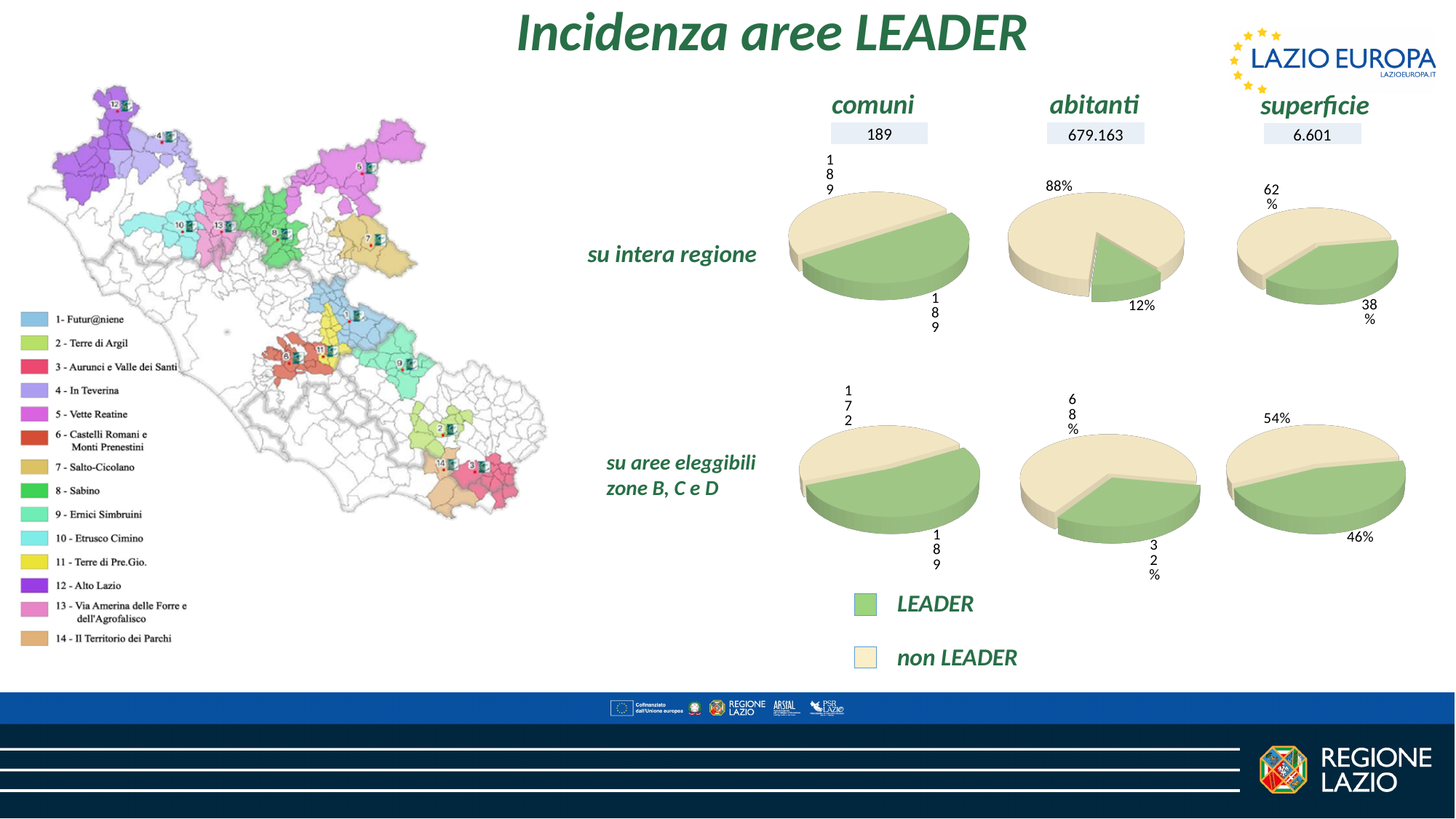
In the 'abitanti' pie chart for 'su intera regione', what percentage is labelled for the LEADER slice? 12% What kind of charts are used on the slide to show the incidence of LEADER areas? Pie charts In the 'abitanti' pie chart for 'su aree eleggibili zone B, C e D', what is the difference in percentage points between the non LEADER and LEADER slices? 36 In the 'abitanti' pie chart for 'su aree eleggibili zone B, C e D', what percentage is labelled for the LEADER slice? 32% In the 'abitanti' pie chart for 'su intera regione', which slice is larger, LEADER or non LEADER? non LEADER How many entries does the legend for the pie charts list? 2 In the 'comuni' pie chart for 'su aree eleggibili zone B, C e D', what value is labelled for the non LEADER slice? 172 What total value is shown above the 'abitanti' column of pie charts? 679.163 In the 'abitanti' pie chart for 'su intera regione', what percentage is labelled for the non LEADER slice? 88% In the 'superficie' pie chart for 'su aree eleggibili zone B, C e D', what percentage is labelled for the non LEADER slice? 54% In the 'superficie' pie chart for 'su aree eleggibili zone B, C e D', what is the difference in percentage points between the non LEADER and LEADER slices? 8 In the 'superficie' pie chart for 'su intera regione', what percentage is labelled for the LEADER slice? 38%